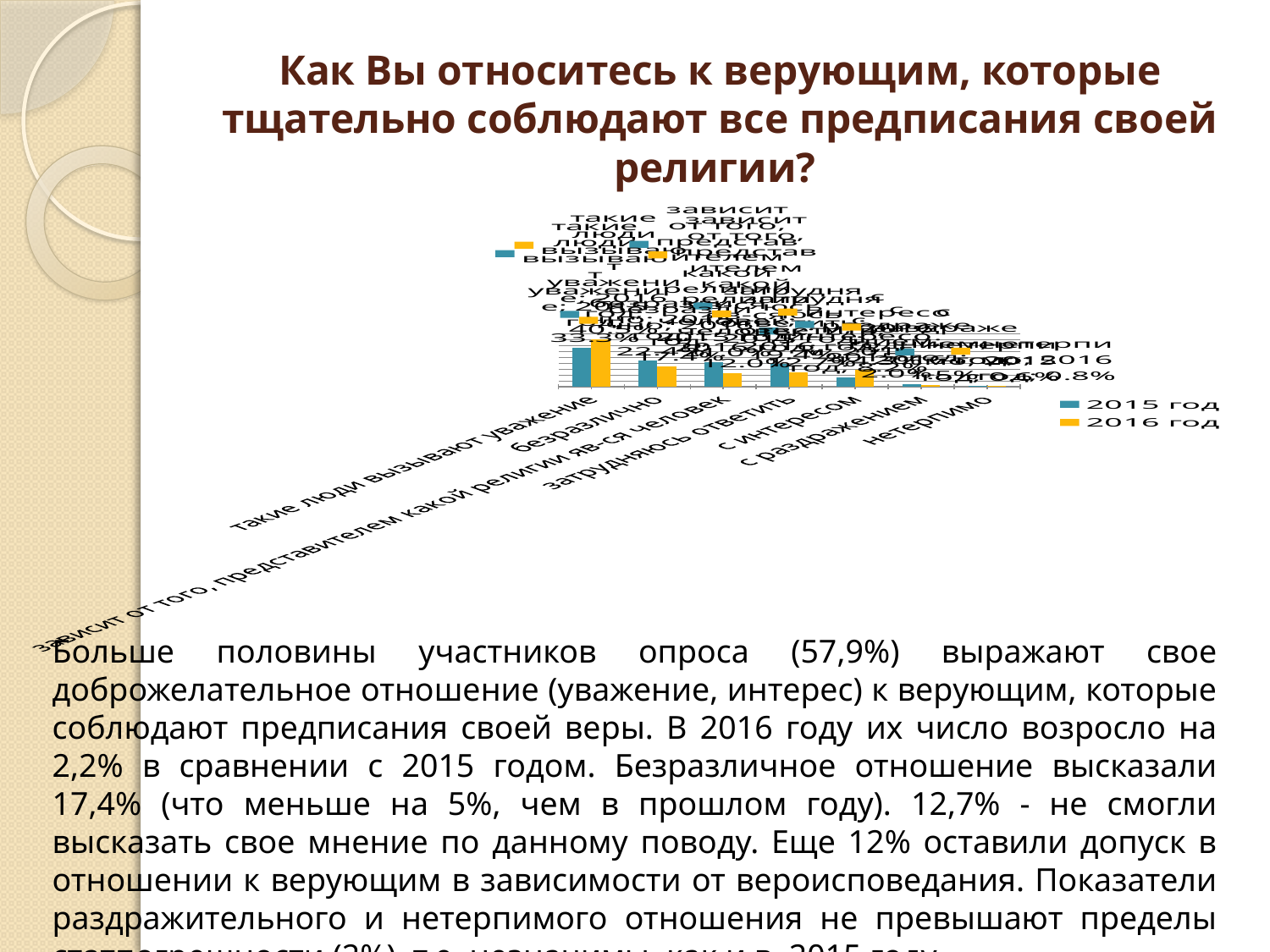
What colour represents the 2016 год series in the chart? yellow Which category has the lowest values in the chart? нетерпимо Which category has the larger values: 'такие люди вызывают уважение' or 'безразлично'? такие люди вызывают уважение What kind of chart is shown on the slide? bar chart Which category has the larger values: 'безразлично' or 'с раздражением'? безразлично Which category has the highest values in the chart? такие люди вызывают уважение Do the bar values generally rise or fall moving from left to right along the x axis? fall How many series does the chart legend list? 2 How many categories are shown along the x axis of the chart? 7 Which two series are listed in the chart legend? 2015 год and 2016 год Which category is the first one on the left of the x axis? такие люди вызывают уважение